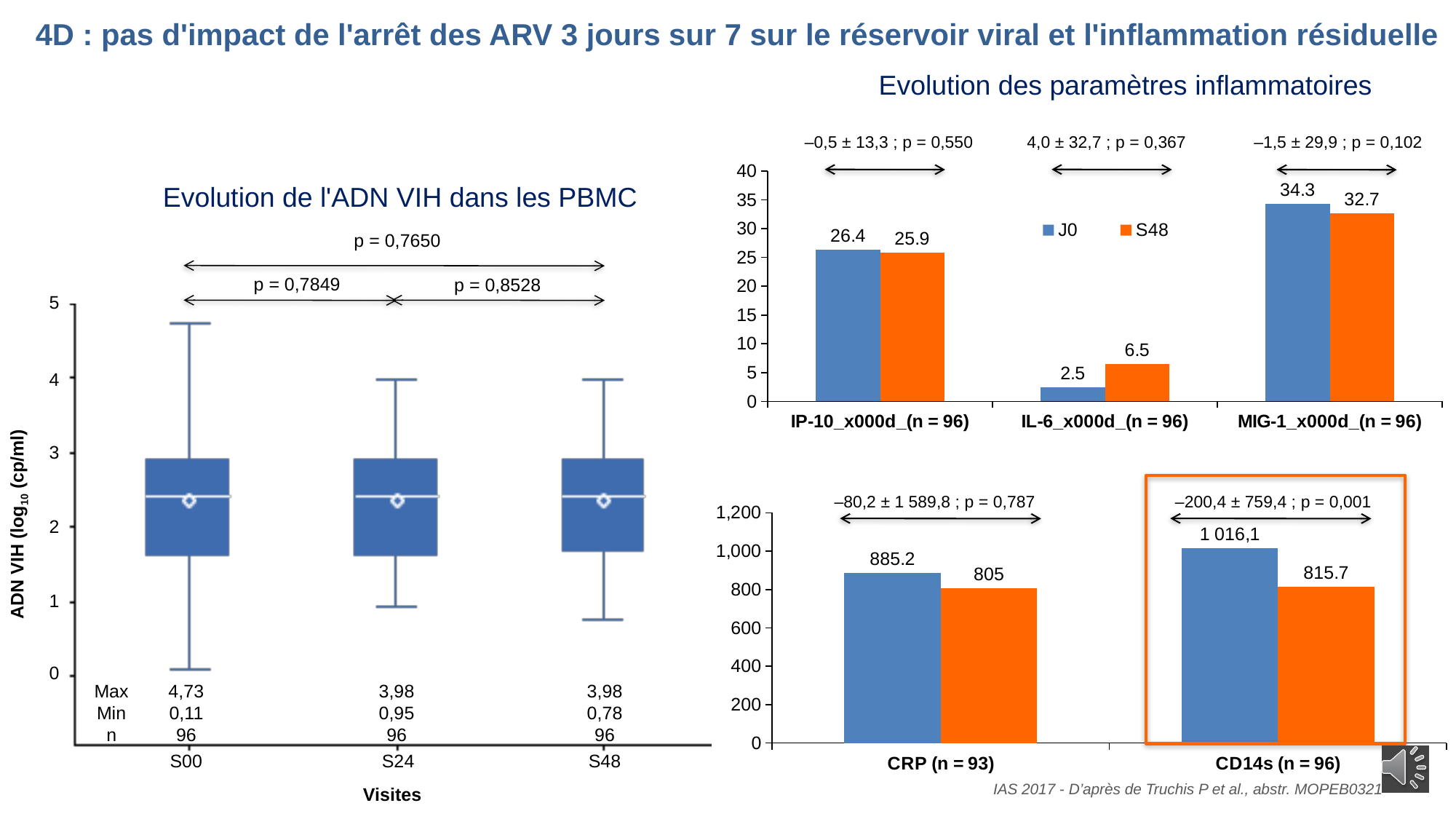
In the top-right chart 'Evolution des paramètres inflammatoires', for IL-6, which is larger: the J0 value or the S48 value? S48 How many categories are shown on the x axis of the top-right chart 'Evolution des paramètres inflammatoires'? 3 In the top-right chart 'Evolution des paramètres inflammatoires', what is the difference between the J0 and S48 values for MIG-1? 1.6 In the bottom-right chart (CRP and CD14s), what is the S48 value for CRP? 805 In the top-right chart 'Evolution des paramètres inflammatoires', what is the S48 value for IL-6? 6.5 In the left chart 'Evolution de l'ADN VIH dans les PBMC', what is the Max value at visit S00? 4,73 In the top-right chart 'Evolution des paramètres inflammatoires', what is the J0 value for IP-10? 26.4 What kind of chart is the bottom-right chart showing CRP and CD14s? bar chart How many series does the legend of the top-right chart 'Evolution des paramètres inflammatoires' list? 2 In the bottom-right chart (CRP and CD14s), what is the difference between the J0 and S48 values for CRP? 80.2 In the bottom-right chart (CRP and CD14s), what is the J0 value for CD14s? 1 016,1 In the top-right chart 'Evolution des paramètres inflammatoires', which category has the highest J0 value? MIG-1